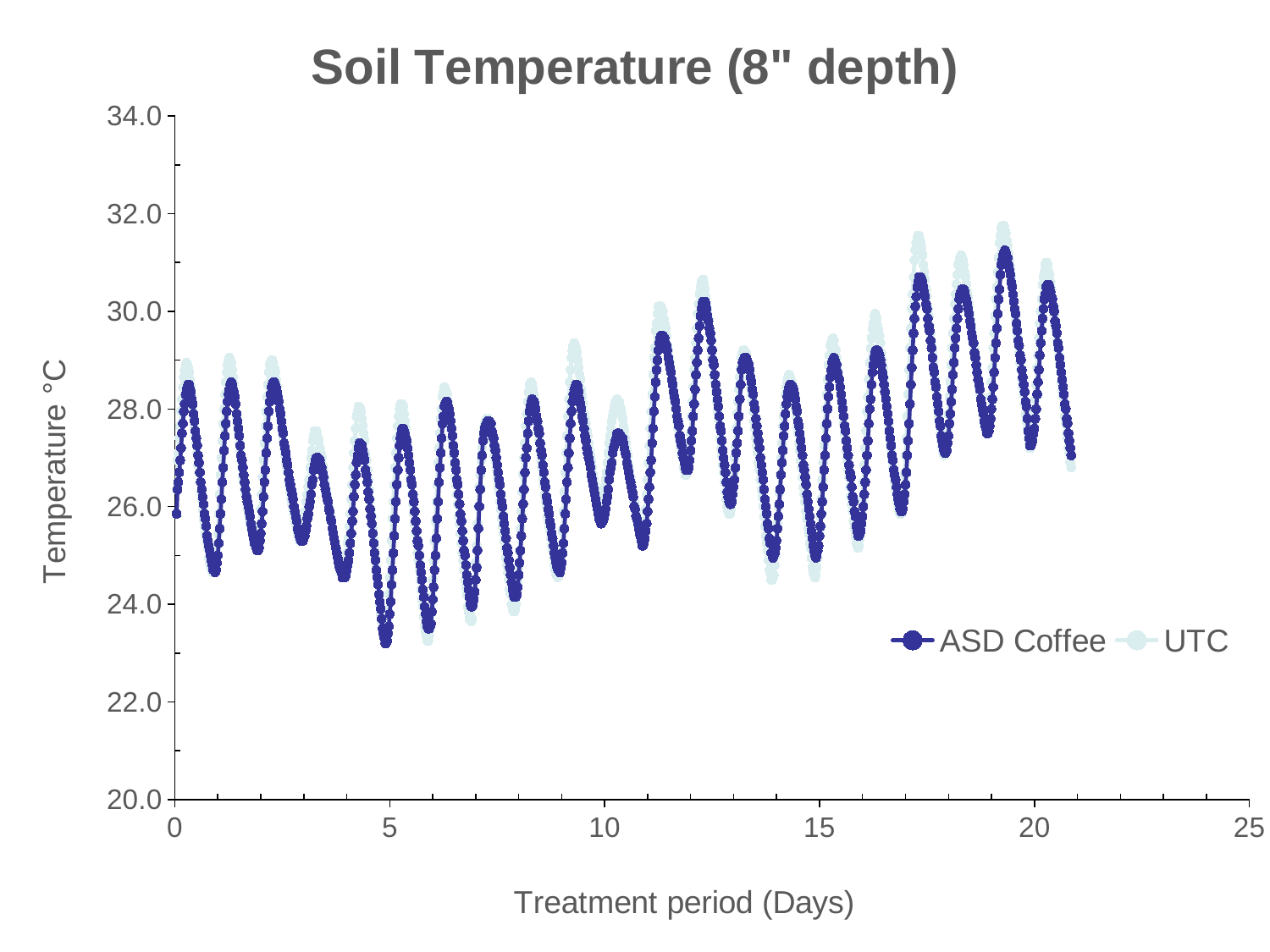
What kind of chart is shown on the slide? line chart Is the ASD Coffee peak around day 12 greater or less than 28.0? greater Do the daily peak temperatures generally rise or fall between day 5 and day 20? rise Is the highest UTC value greater or less than 32.0? less Is the lowest UTC value greater or less than 22.0? greater How many series does the legend list? 2 What is the title of the chart? Soil Temperature (8" depth) Which series reaches the higher peak around day 19, ASD Coffee or UTC? UTC What is the label on the y axis? Temperature °C